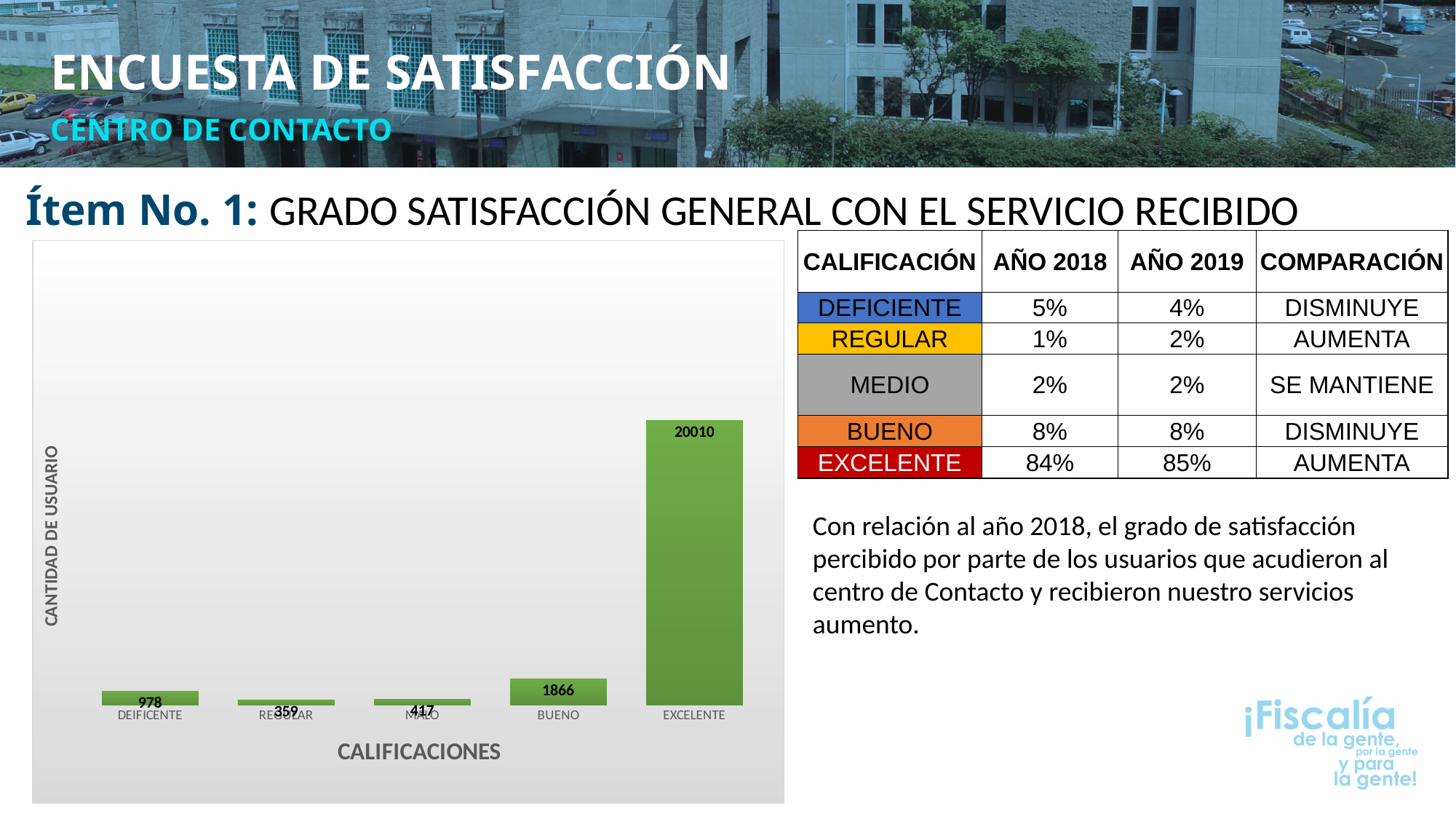
What is the value for EXCELENTE in the bar chart? 20010 What is the difference between the values for EXCELENTE and BUENO in the bar chart? 18144 Which category has the lowest value in the bar chart? REGULAR How many categories are shown in the bar chart? 5 What is the title of the vertical axis of the bar chart? CANTIDAD DE USUARIO What kind of chart is shown on the slide? bar chart Which is larger in the bar chart, the value for MALO or the value for REGULAR? MALO What is the value for BUENO in the bar chart? 1866 What is the value for MALO in the bar chart? 417 Which category has the highest value in the bar chart? EXCELENTE What is the value for DEIFICENTE in the bar chart? 978 What is the difference between the values for BUENO and DEIFICENTE in the bar chart? 888